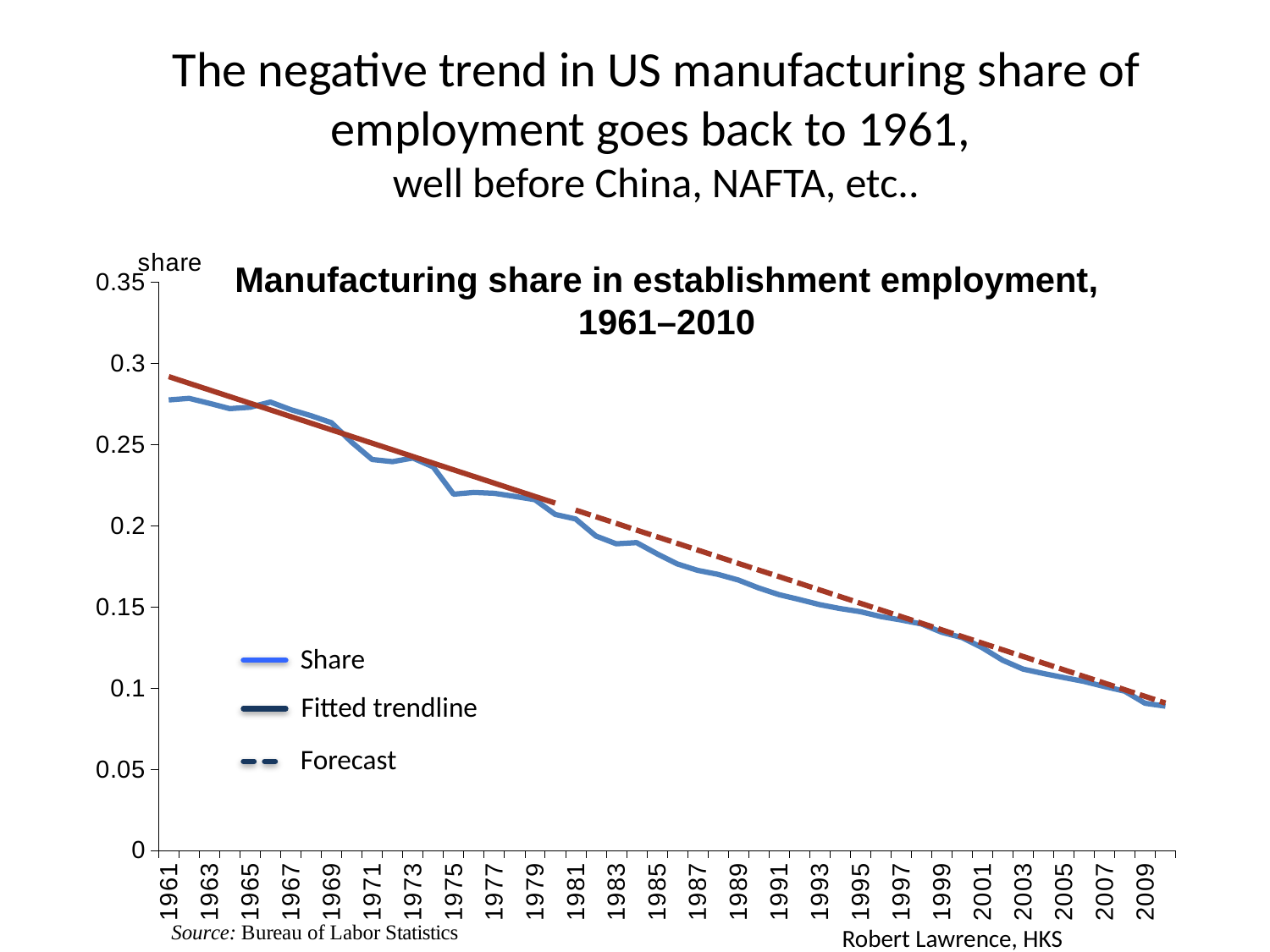
What kind of chart is shown on the slide? line chart Is the value of Share for 2009 greater or less than 0.1? less Does the manufacturing share rise or fall from 1961 to 2009? fall Is the value of Share for 1985 greater or less than 0.2? less Is the value of Share for 1991 greater or less than 0.15? greater How many series does the chart legend list? 3 What is the title of the chart? Manufacturing share in establishment employment, 1961–2010 Which year has the larger Share value, 1961 or 2009? 1961 What source is cited for the chart data? Bureau of Labor Statistics